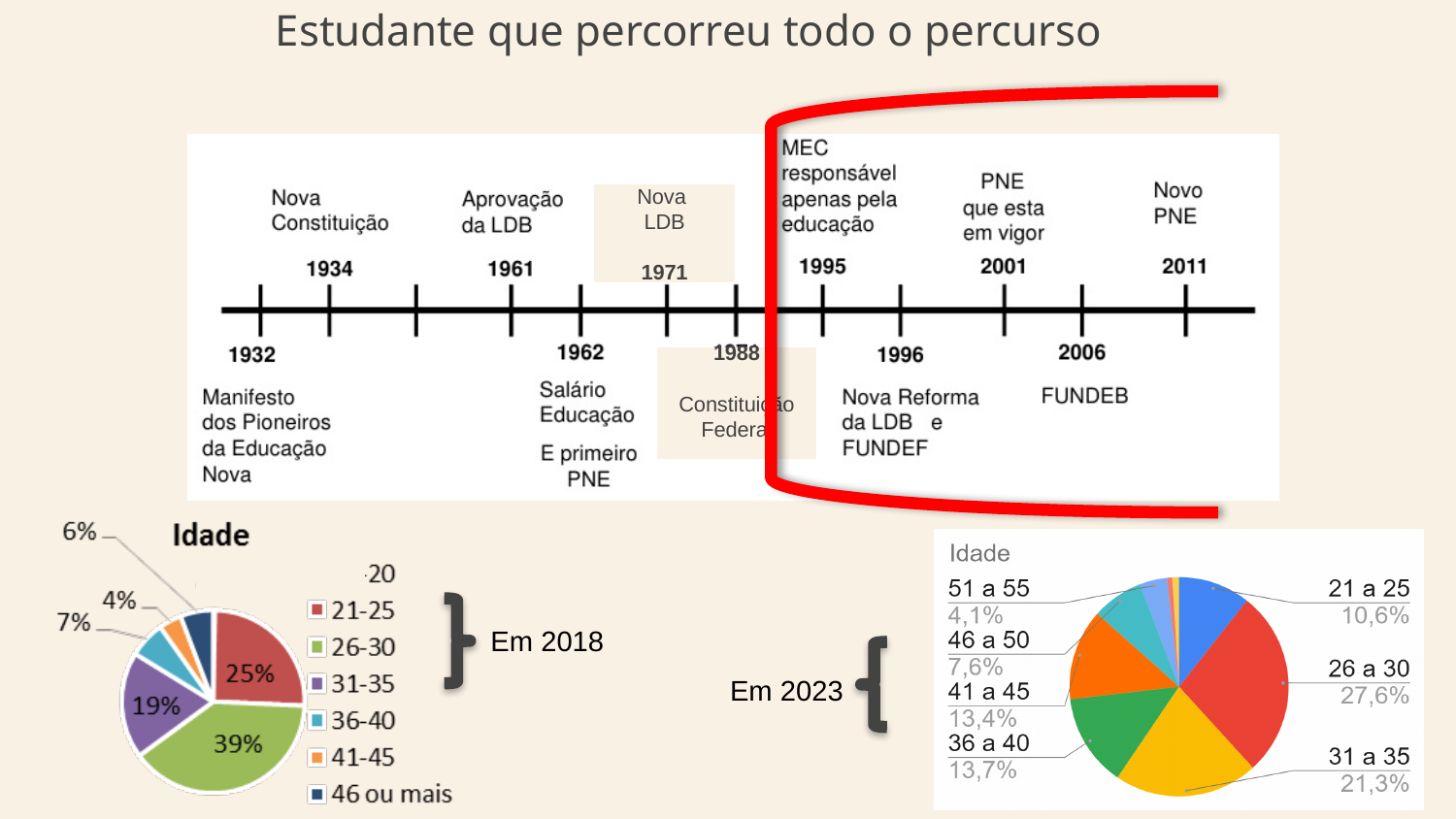
What type of chart is used for the 'Em 2018' and 'Em 2023' age data? Pie chart In the 'Em 2023' pie chart, what is the difference between the shares of the 31 a 35 and 21 a 25 age groups? 10,7% In the 'Em 2018' pie chart, what is the difference between the shares of the 26-30 and 21-25 age groups? 14% In the 'Em 2018' pie chart, which is larger: the share for 36-40 or the share for 41-45? 36-40 In the 'Em 2023' pie chart, which is larger: the share for 46 a 50 or the share for 51 a 55? 46 a 50 In the 'Em 2023' pie chart, what percentage is shown for the 36 a 40 age group? 13,7% In the 'Em 2018' pie chart, which age group has the largest share? 26-30 In the 'Em 2018' pie chart, what percentage is shown for the 31-35 age group? 19% In the 'Em 2023' pie chart, what percentage is shown for the 26 a 30 age group? 27,6% In the 'Em 2023' pie chart, which age group has the largest share? 26 a 30 How many entries does the legend of the 'Em 2018' pie chart list? 7 In the 'Em 2018' pie chart, what percentage is shown for the 26-30 age group? 39%